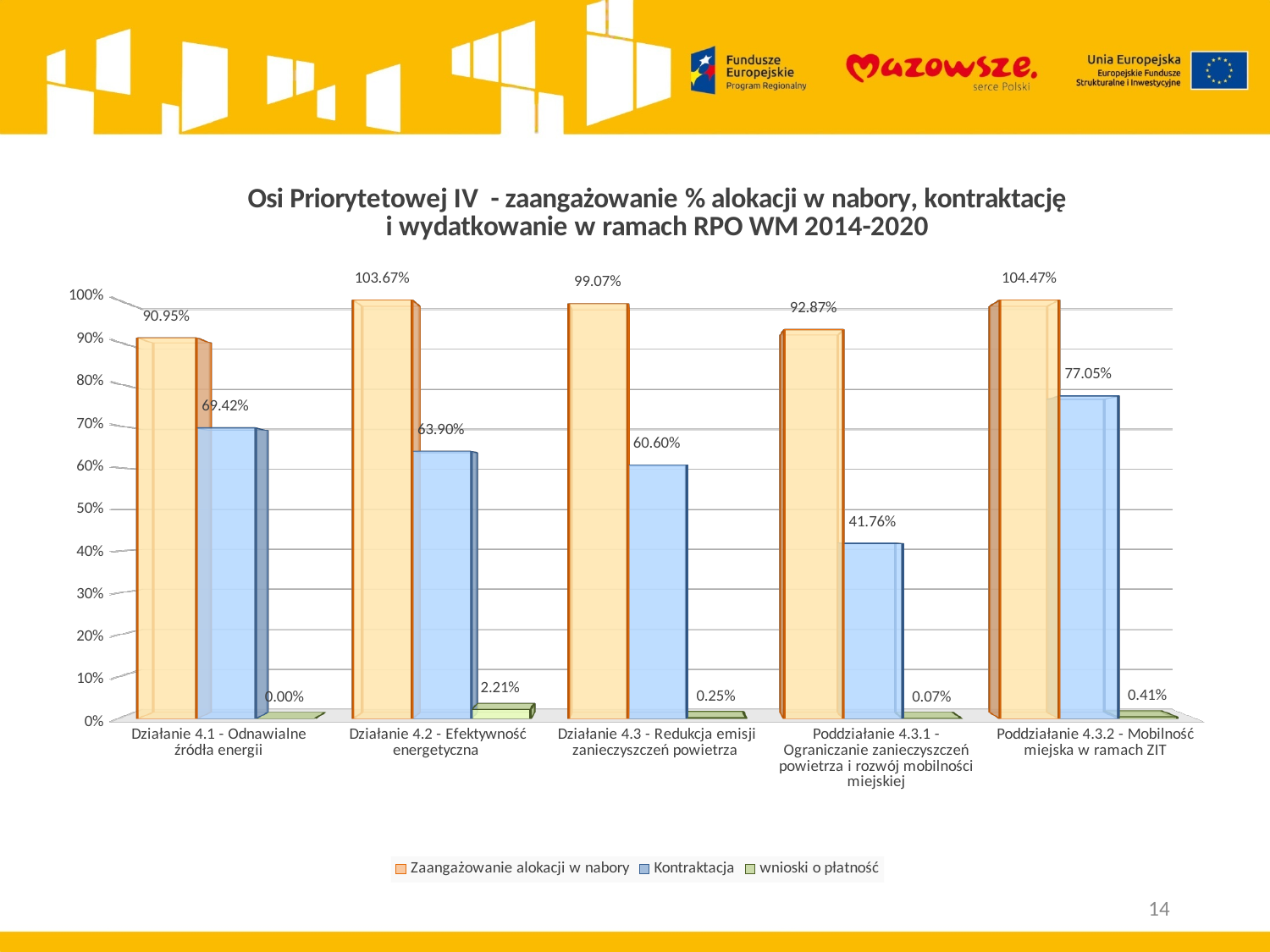
Which category has the highest Zaangażowanie alokacji w nabory value? Poddziałanie 4.3.2 - Mobilność miejska w ramach ZIT Which is larger: the Kontraktacja value for Działanie 4.2 - Efektywność energetyczna or for Poddziałanie 4.3.2 - Mobilność miejska w ramach ZIT? Poddziałanie 4.3.2 - Mobilność miejska w ramach ZIT What is the Zaangażowanie alokacji w nabory value for Poddziałanie 4.3.1 - Ograniczanie zanieczyszczeń powietrza i rozwój mobilności miejskiej? 92.87% Which category has the lowest Kontraktacja value? Poddziałanie 4.3.1 - Ograniczanie zanieczyszczeń powietrza i rozwój mobilności miejskiej How many categories are shown on the x axis? 5 What is the wnioski o płatność value for Działanie 4.2 - Efektywność energetyczna? 2.21% What is the Kontraktacja value for Działanie 4.1 - Odnawialne źródła energii? 69.42% What kind of chart is shown on the slide? bar chart Is the Kontraktacja value for Poddziałanie 4.3.1 greater or less than 50%? less Which series is shown in green in the legend? wnioski o płatność What is the difference between the Zaangażowanie alokacji w nabory and Kontraktacja values for Działanie 4.3 - Redukcja emisji zanieczyszczeń powietrza? 38.47% How many series does the legend list? 3